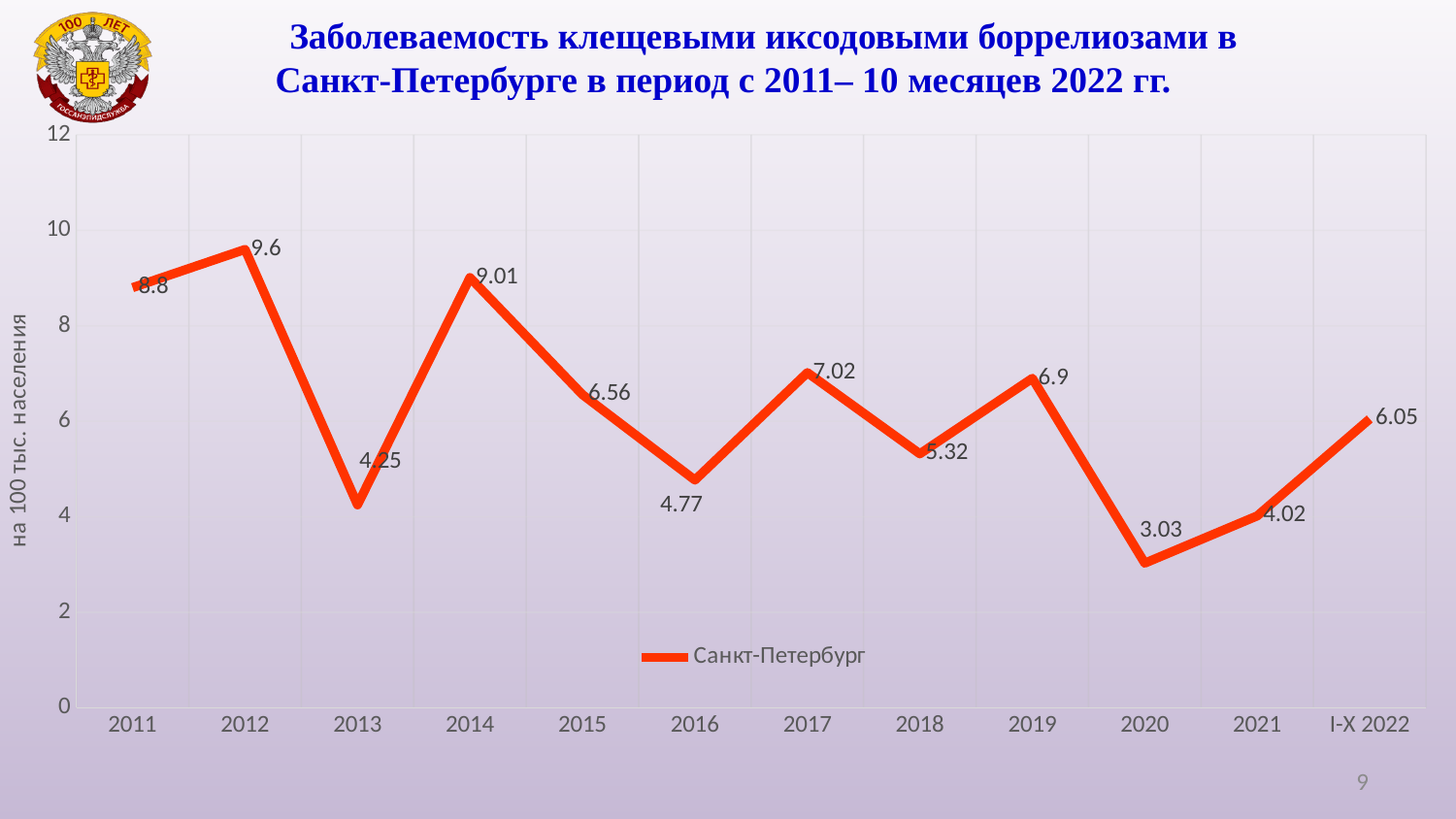
What is the value for I-X 2022? 6.05 What type of chart is shown on the slide? line chart Is the value for 2018 greater or less than 6? less Which year has the lowest value? 2020 Which is larger, the value for 2017 or the value for 2019? 2017 Which year has the highest value? 2012 What series name is shown in the legend? Санкт-Петербург What is the value for 2012? 9.6 What is the difference between the values for 2014 and 2013? 4.76 Do the values rise or fall from 2019 to 2020? fall What is the value for 2020? 3.03 How many data points are plotted on the chart? 12